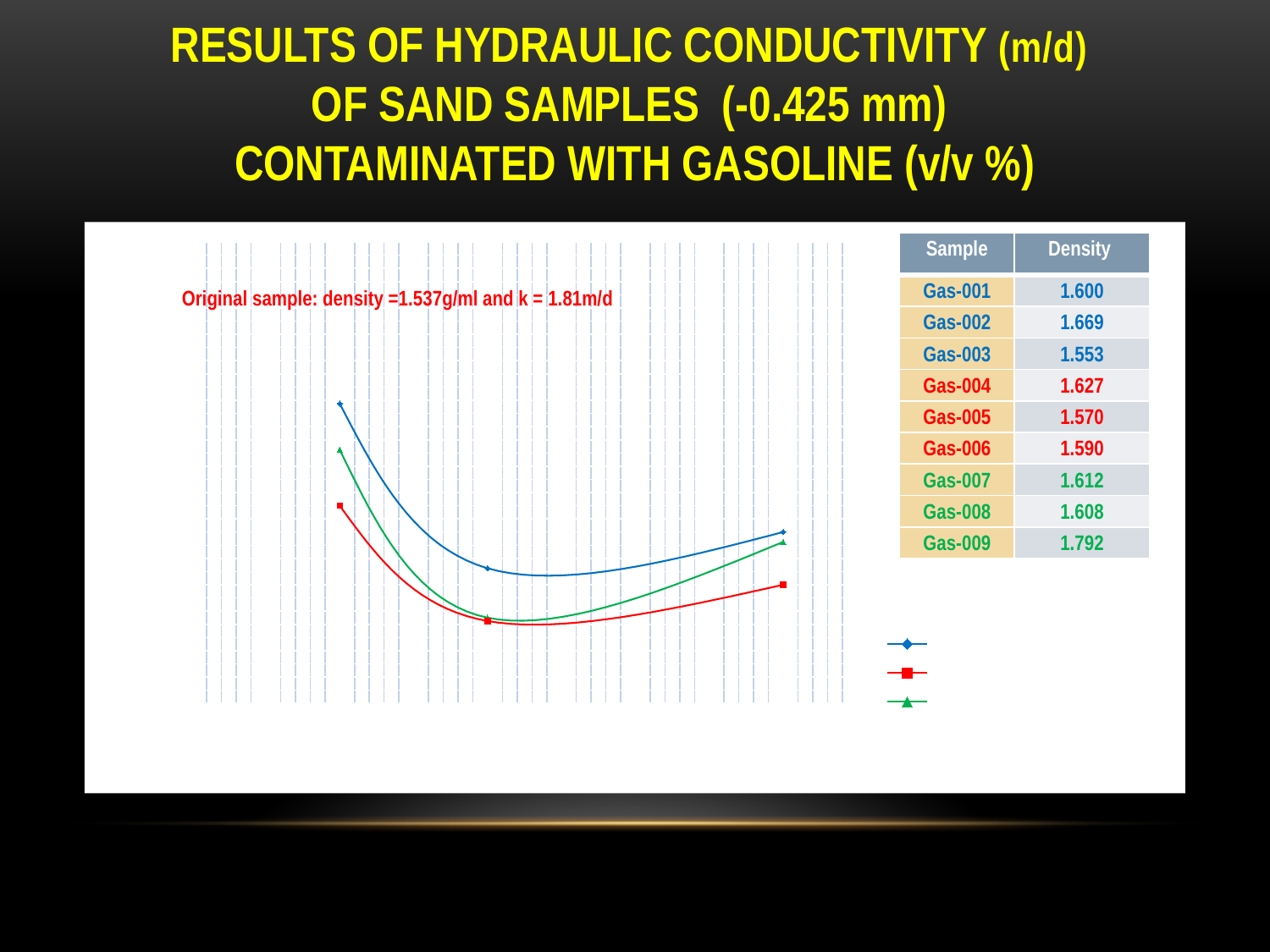
How many series does the chart's legend list? 3 Do the values of the blue series rise or fall from the first point to the second point along the x axis? fall What density and hydraulic conductivity does the chart's annotation give for the original sample? density = 1.537 g/ml and k = 1.81 m/d How many data points are plotted on the blue series? 3 Do the values of the red series rise or fall from the second point to the third point along the x axis? rise What marker shape is used for the green series in the legend? triangle Which series has the lowest value at the last plotted point: the blue, red or green series? red Which series has the highest value at the first plotted point: the blue, red or green series? blue How many data points are plotted on the red series? 3 What kind of chart is shown on the slide? line chart At the first plotted point, is the value of the green series larger or smaller than the value of the red series? larger